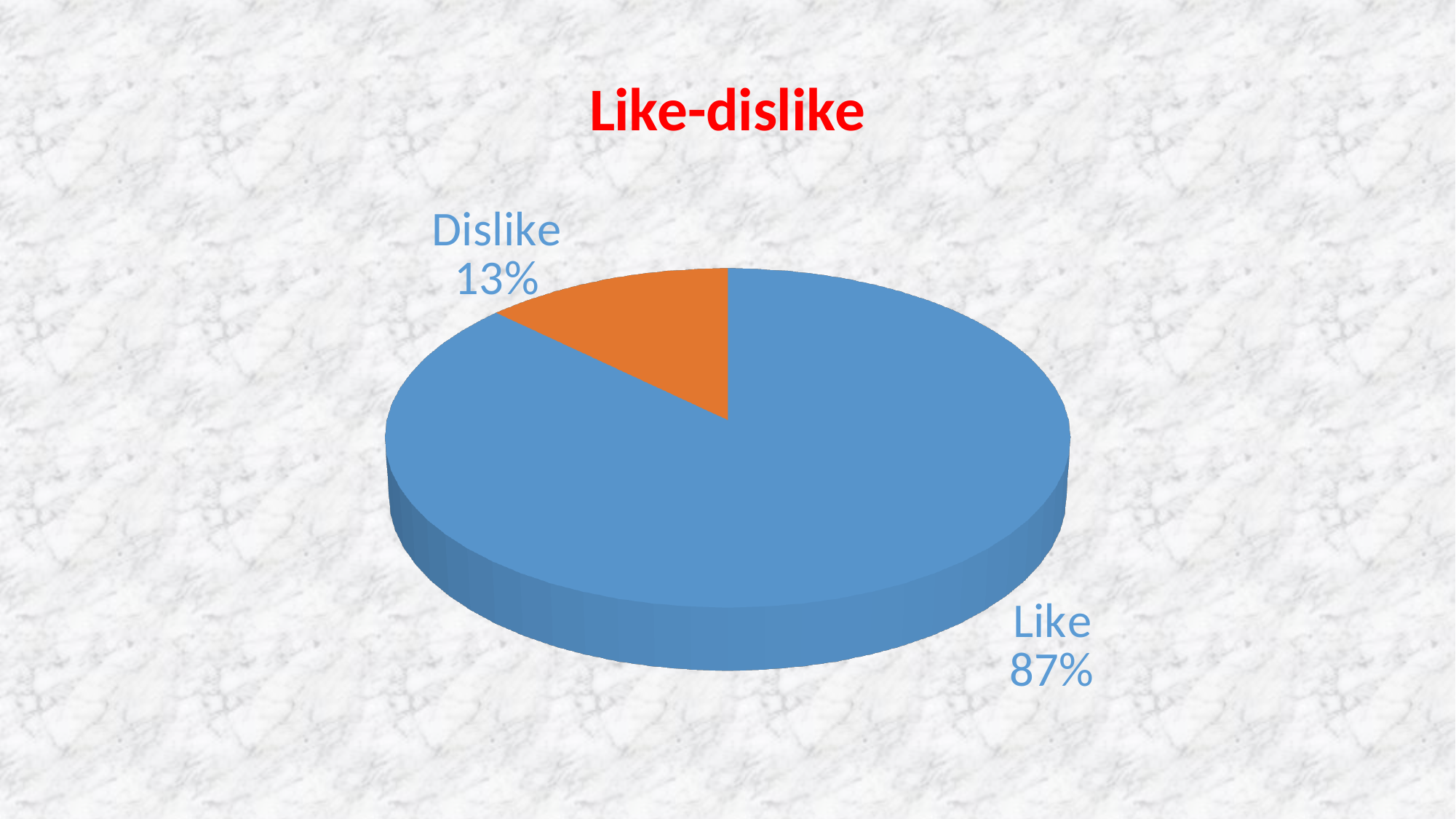
What share of the pie does the Like slice take? 87% What percentage of the pie is labelled Dislike? 13% How many slices does the pie chart have? 2 What percentage of the pie is labelled Like? 87% What kind of chart is shown on the slide? pie chart What is the title of the chart? Like-dislike Which slice is the smallest? Dislike Which is larger, the Like slice or the Dislike slice? Like What is the difference in percentage points between the Like and Dislike slices? 74 What colour is the Dislike slice? orange Which slice is the largest? Like